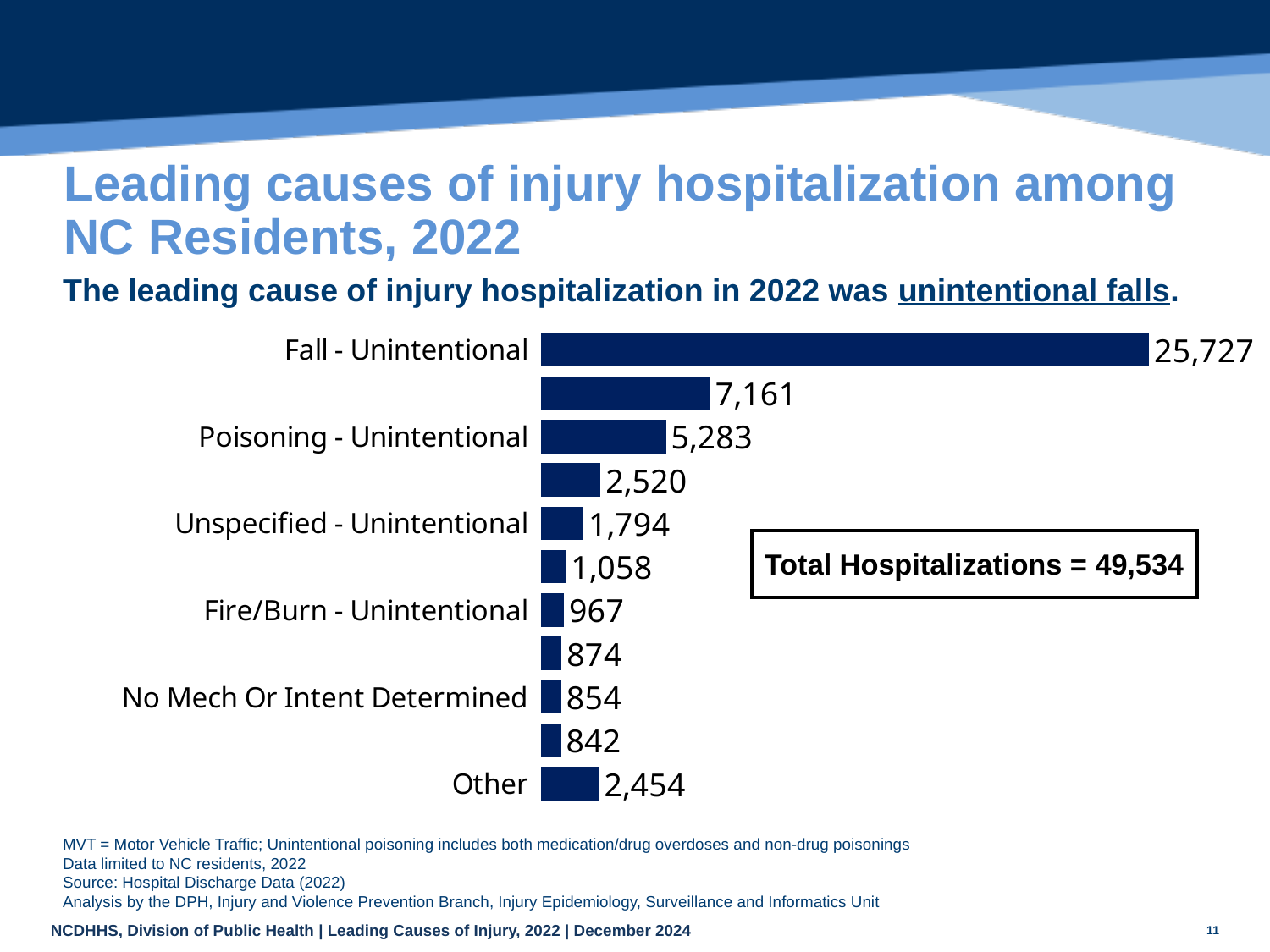
What is the difference between the Fall - Unintentional and Poisoning - Unintentional values? 20,444 How many injury hospitalizations were attributed to Fall - Unintentional? 25,727 Which is larger, the value for Other or the value for Unspecified - Unintentional? Other How many hospitalizations are shown for Fire/Burn - Unintentional? 967 What is the value shown for the Other category? 2,454 What is the value shown for Unspecified - Unintentional? 1,794 What is the value shown for Poisoning - Unintentional? 5,283 What total number of hospitalizations is stated in the box on the chart? 49,534 Which category has the highest number of injury hospitalizations? Fall - Unintentional How many bars are plotted in the chart? 11 What is the value for No Mech Or Intent Determined? 854 What type of chart is shown on the slide? Bar chart